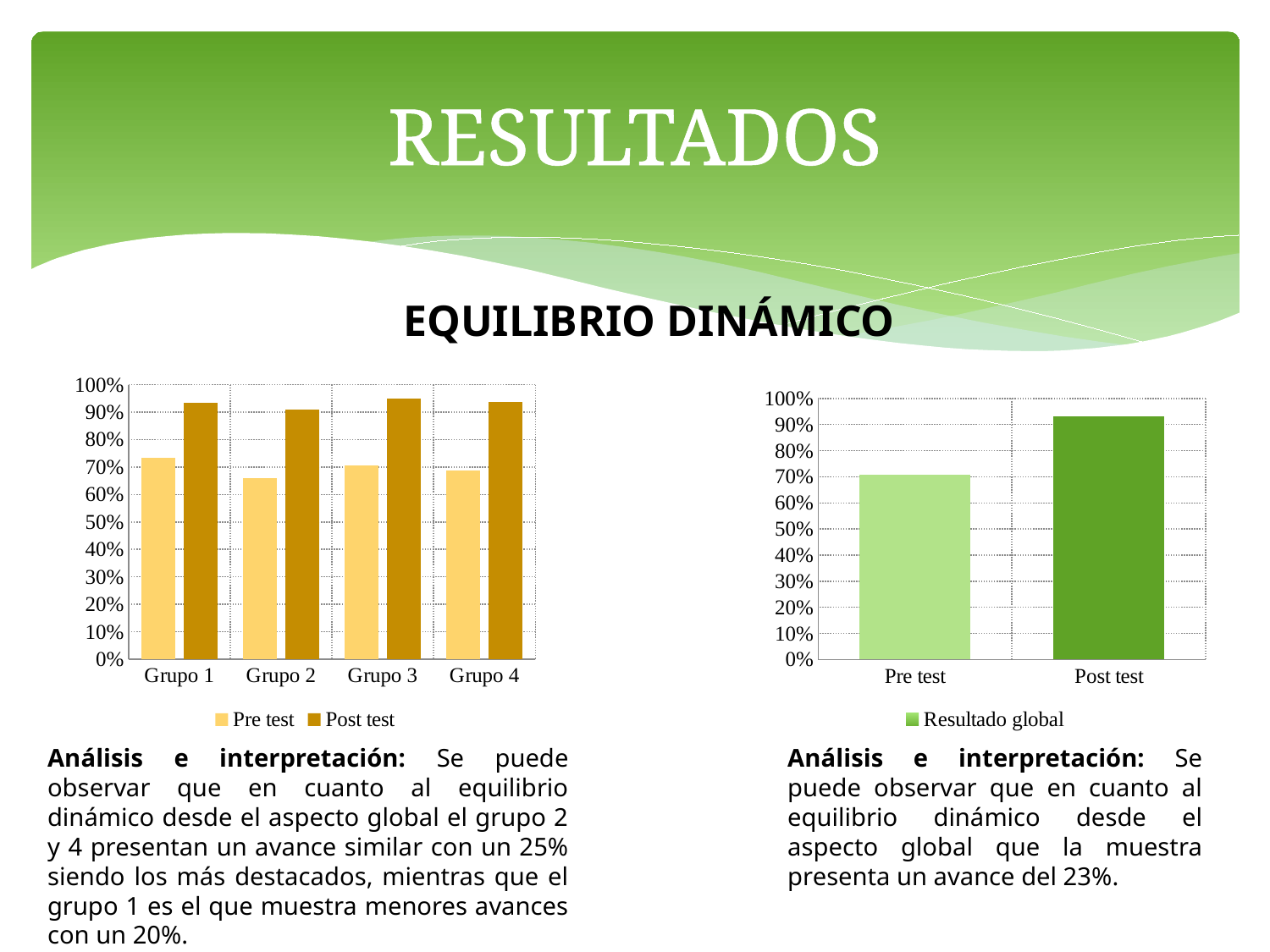
How many series does the legend of the right chart list? 1 What are the two legend entries of the left chart? Pre test, Post test In the left chart, is the Post test value for Grupo 1 greater or less than 80%? greater In the left chart, which is larger for Grupo 2: the Pre test value or the Post test value? Post test How many groups (categories) are shown on the x axis of the left chart? 4 How many categories are shown on the x axis of the right chart? 2 How many series does the legend of the left chart list? 2 In the right chart, which bar is taller: Pre test or Post test? Post test In the left chart, is the Post test value for Grupo 3 greater or less than 90%? greater What kind of chart is the left chart with Grupo 1 to Grupo 4? bar chart In the left chart, is the Pre test value for Grupo 2 greater or less than 70%? less